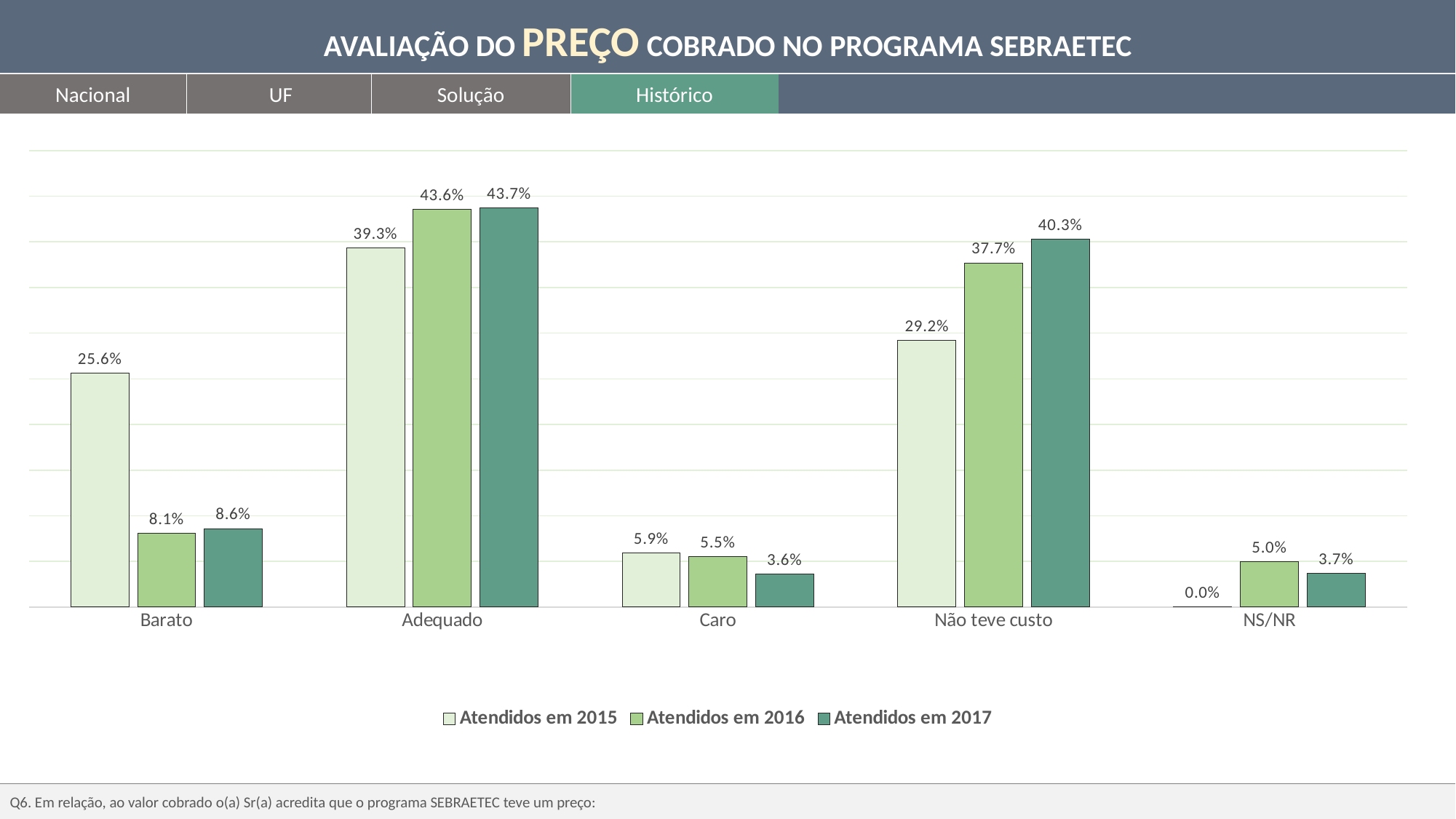
What is the value for Não teve custo in the Atendidos em 2017 series? 40.3% Which category has the highest value in the Atendidos em 2016 series? Adequado For Não teve custo, do the values rise or fall from Atendidos em 2015 to Atendidos em 2017? Rise What is the value for Caro in the Atendidos em 2016 series? 5.5% How many series does the legend list? 3 What is the value for Barato in the Atendidos em 2015 series? 25.6% For Não teve custo, which is larger: the Atendidos em 2016 value or the Atendidos em 2017 value? Atendidos em 2017 How many categories are shown on the x axis of the chart? 5 What is the difference between the Atendidos em 2017 and Atendidos em 2015 values for Adequado? 4.4 percentage points Which category has the lowest value in the Atendidos em 2015 series? NS/NR What is the difference between the Atendidos em 2015 and Atendidos em 2016 values for Barato? 17.5 percentage points What kind of chart is shown on the slide? Bar chart